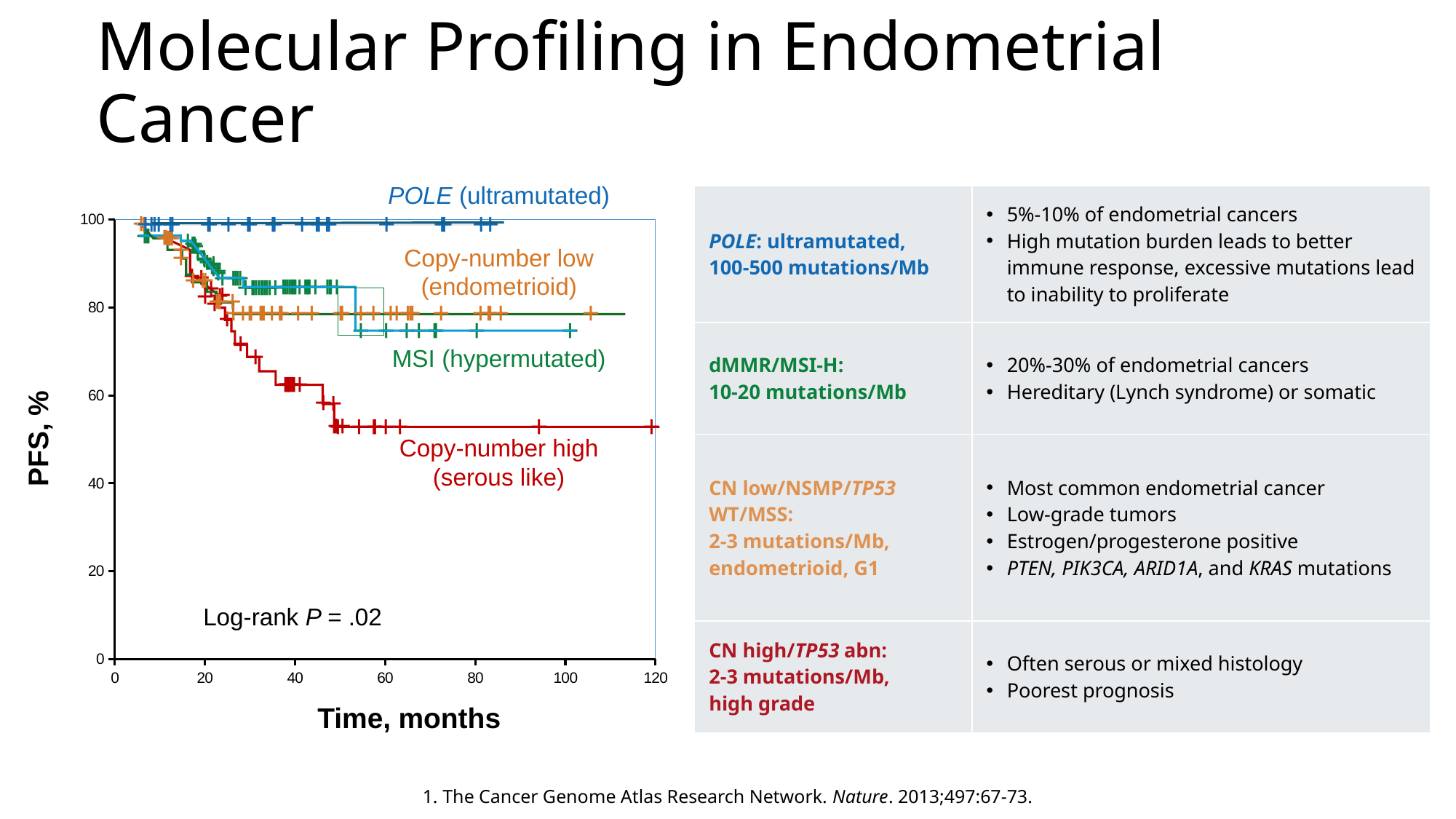
Is the PFS value for Copy-number high (serous like) at 120 months greater or less than 60? less Is the PFS value for POLE (ultramutated) at 80 months greater or less than 80? greater How many molecular subgroups are plotted as curves on the chart? 4 Is the PFS value for Copy-number high (serous like) at 120 months greater or less than 40? greater What is the label of the x axis of the chart? Time, months Which subgroup has the lowest PFS curve on the chart? Copy-number high (serous like) What is the label of the y axis of the chart? PFS, % Does the PFS curve for Copy-number high (serous like) rise or fall as time increases? fall Which subgroup has the highest PFS curve on the chart? POLE (ultramutated) What kind of chart is shown on the slide? Line chart (Kaplan-Meier survival curves)